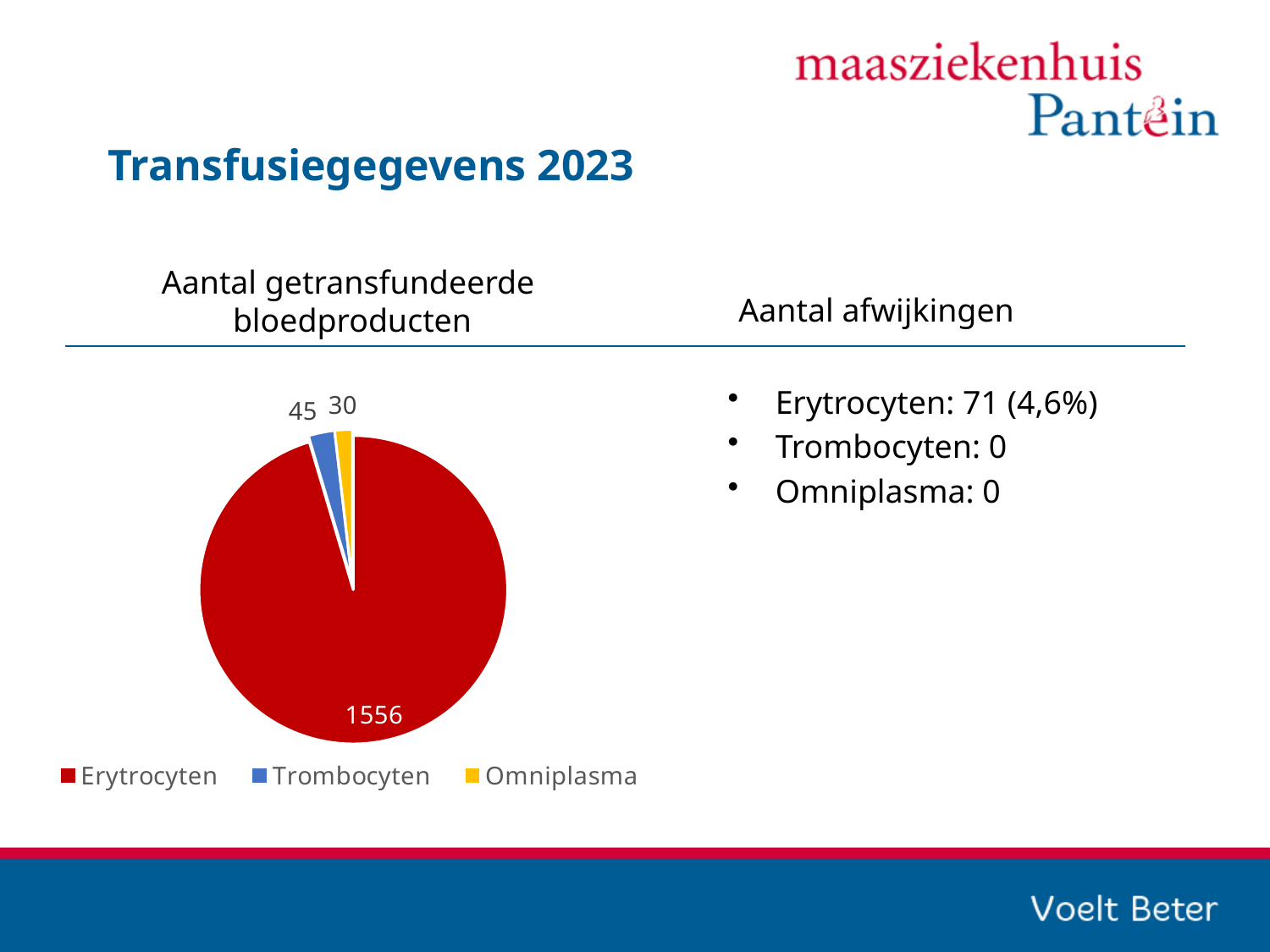
What is the title of the pie chart? Aantal getransfundeerde bloedproducten What type of chart is shown on the slide? Pie chart Which category has the smallest slice in the pie chart? Omniplasma What is the total of all slices in the pie chart? 1631 What is the value for Trombocyten in the pie chart? 45 Which category has the largest slice in the pie chart? Erytrocyten What is the value for Erytrocyten in the pie chart? 1556 Which is larger, the value for Trombocyten or the value for Omniplasma? Trombocyten How many categories does the pie chart show? 3 What is the difference between the values for Erytrocyten and Trombocyten? 1511 What is the difference between the values for Trombocyten and Omniplasma? 15 What is the value for Omniplasma in the pie chart? 30